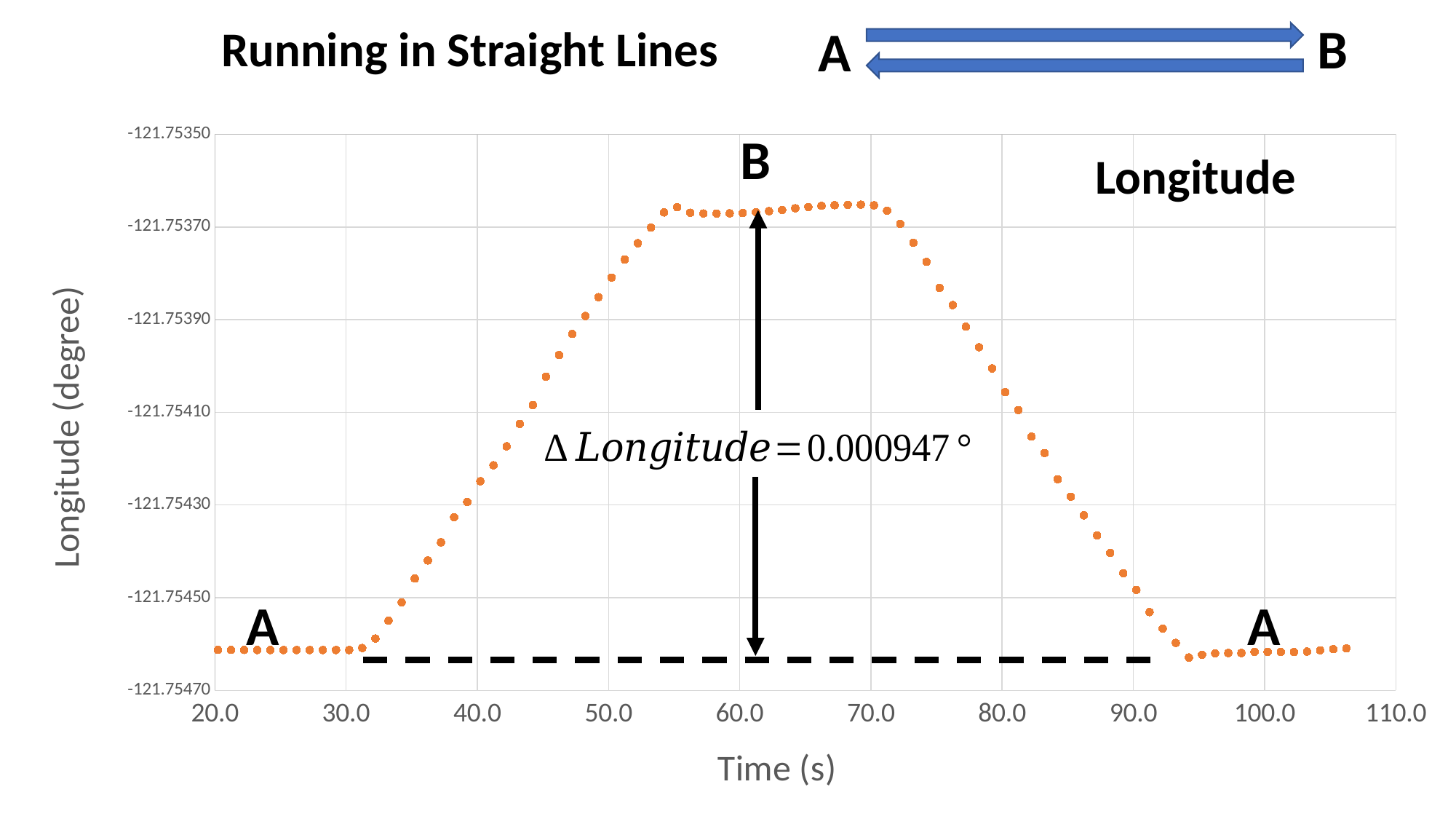
What value of ΔLongitude is printed on the chart? 0.000947° What is the label of the x axis? Time (s) What is the title of the chart? Longitude Do the longitude values rise or fall between 30.0 s and 55.0 s? rise Do the longitude values rise or fall between 70.0 s and 90.0 s? fall At which labelled point, A or B, is the longitude lowest? A What kind of chart is shown on the slide? Scatter plot At which labelled point, A or B, is the longitude highest? B Is the longitude at time 25.0 s greater or less than -121.75450? less Is the longitude at time 40.0 s greater or less than -121.75430? greater Is the longitude at time 40.0 s greater or less than -121.75410? less